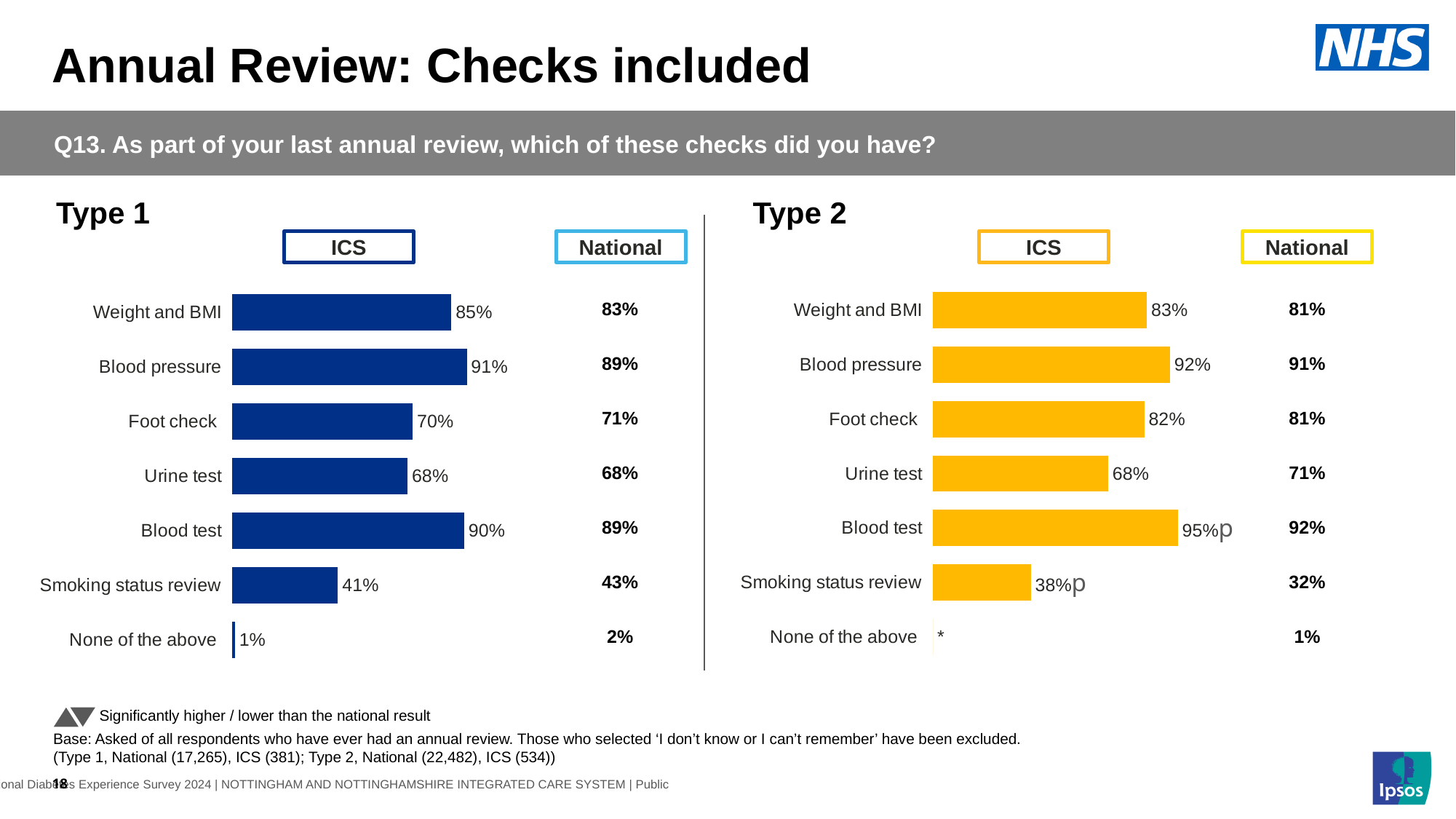
What colour are the ICS bars in the Type 2 chart? yellow/orange In the Type 2 chart, is the ICS value for Foot check higher or lower than the National value? higher What type of chart is used for the Type 1 data? bar chart In the Type 2 chart, which check has the lowest ICS value among those with a printed percentage? Smoking status review In the Type 1 chart, which check has the highest ICS value? Blood pressure In the Type 2 chart, what is the difference between the ICS and National values for Smoking status review? 6 percentage points In the Type 2 chart, what is the ICS value for Blood test? 95% In the Type 2 chart, what is the National value for Urine test? 71% In the Type 1 chart, what is the National value for Smoking status review? 43% In the Type 1 chart, what is the difference between the ICS and National values for Weight and BMI? 2 percentage points In the Type 1 chart, how many checks are listed? 7 In the Type 1 chart, what is the ICS value for Blood pressure? 91%